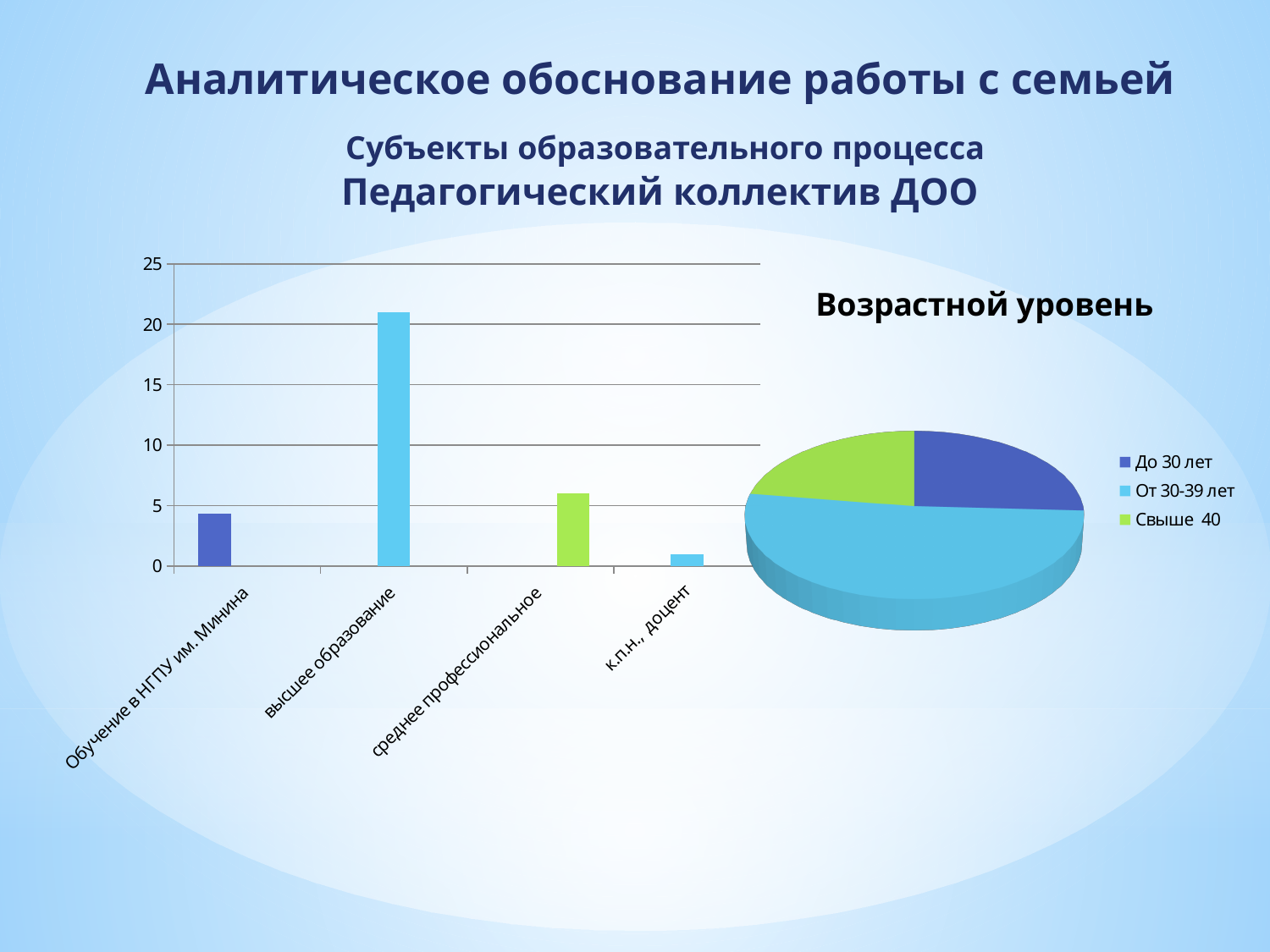
In the pie chart "Возрастной уровень", which age group has the largest slice? От 30-39 лет In the bar chart on the left, is the value for "Обучение в НГПУ им. Минина" greater or less than 5? less In the bar chart on the left, is the value for "высшее образование" greater or less than 20? greater What kind of chart is the chart titled "Возрастной уровень"? pie chart What kind of chart is the chart on the left side of the slide? bar chart In the bar chart on the left, is the value for "к.п.н., доцент" greater or less than 5? less In the bar chart on the left, which is larger: the value for "среднее профессиональное" or the value for "Обучение в НГПУ им. Минина"? среднее профессиональное In the pie chart "Возрастной уровень", how many entries does the legend list? 3 In the bar chart on the left, which category has the highest value? высшее образование In the bar chart on the left, how many categories are shown on the x axis? 4 In the bar chart on the left, which category has the lowest value? к.п.н., доцент